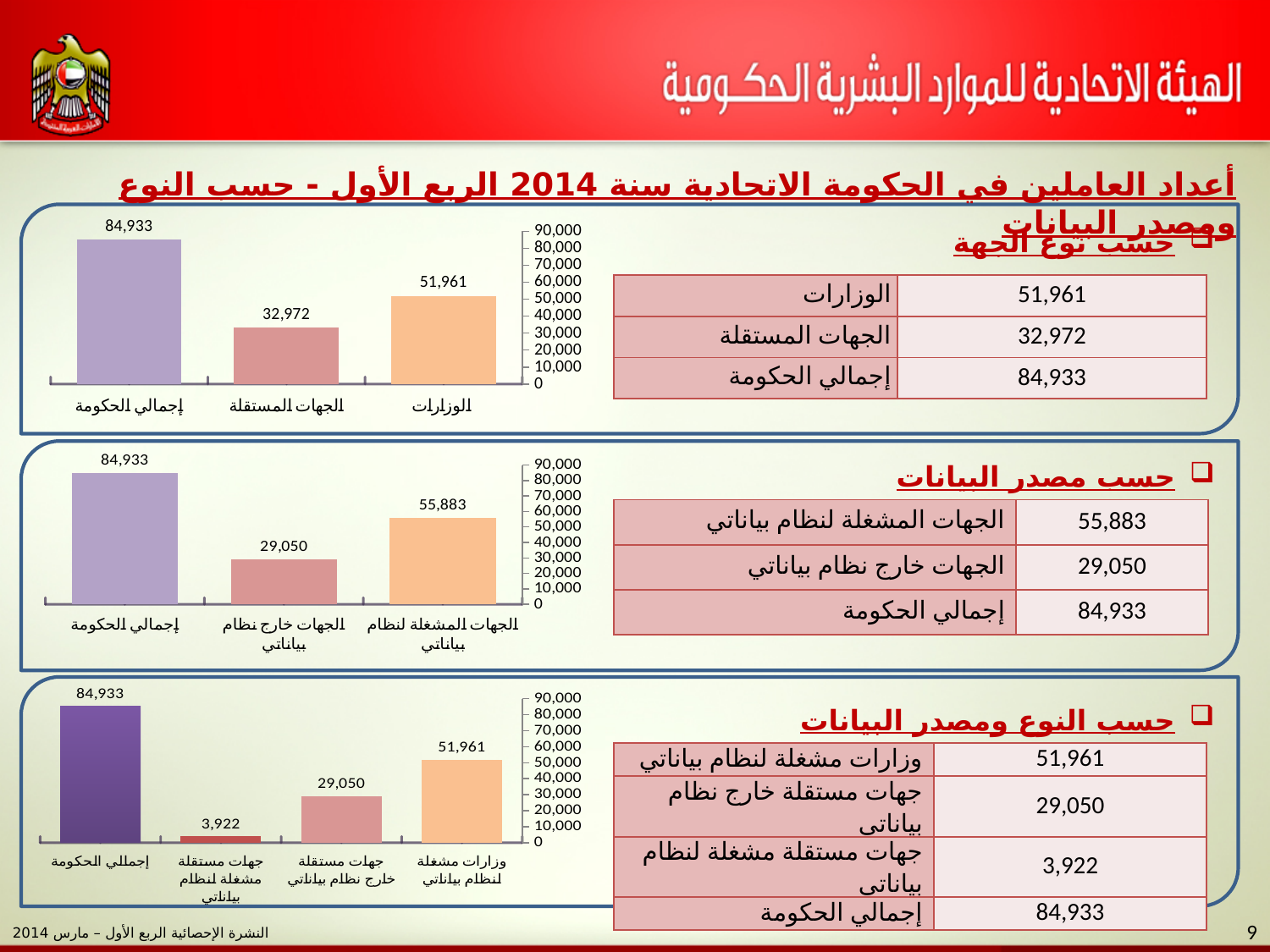
In the bottom chart, what is the value for جهات مستقلة مشغلة لنظام بياناتي? 3,922 In the top chart, what is the difference between إجمالي الحكومة and الوزارات? 32,972 In the middle chart, what is the value for الجهات المشغلة لنظام بياناتي? 55,883 In the bottom chart, which is larger: وزارات مشغلة لنظام بياناتي or جهات مستقلة خارج نظام بياناتي? وزارات مشغلة لنظام بياناتي In the middle chart, which category has the lowest value? الجهات خارج نظام بياناتي What type of chart is the bottom chart? Bar chart In the bottom chart, which category has the highest value? إجمالي الحكومة In the middle chart, is the value for الجهات المشغلة لنظام بياناتي greater or less than 50,000? greater In the top chart, what is the value for الوزارات? 51,961 In the top chart, how many bars are plotted? 3 In the top chart, what is the value for الجهات المستقلة? 32,972 In the middle chart, what is the value for الجهات خارج نظام بياناتي? 29,050